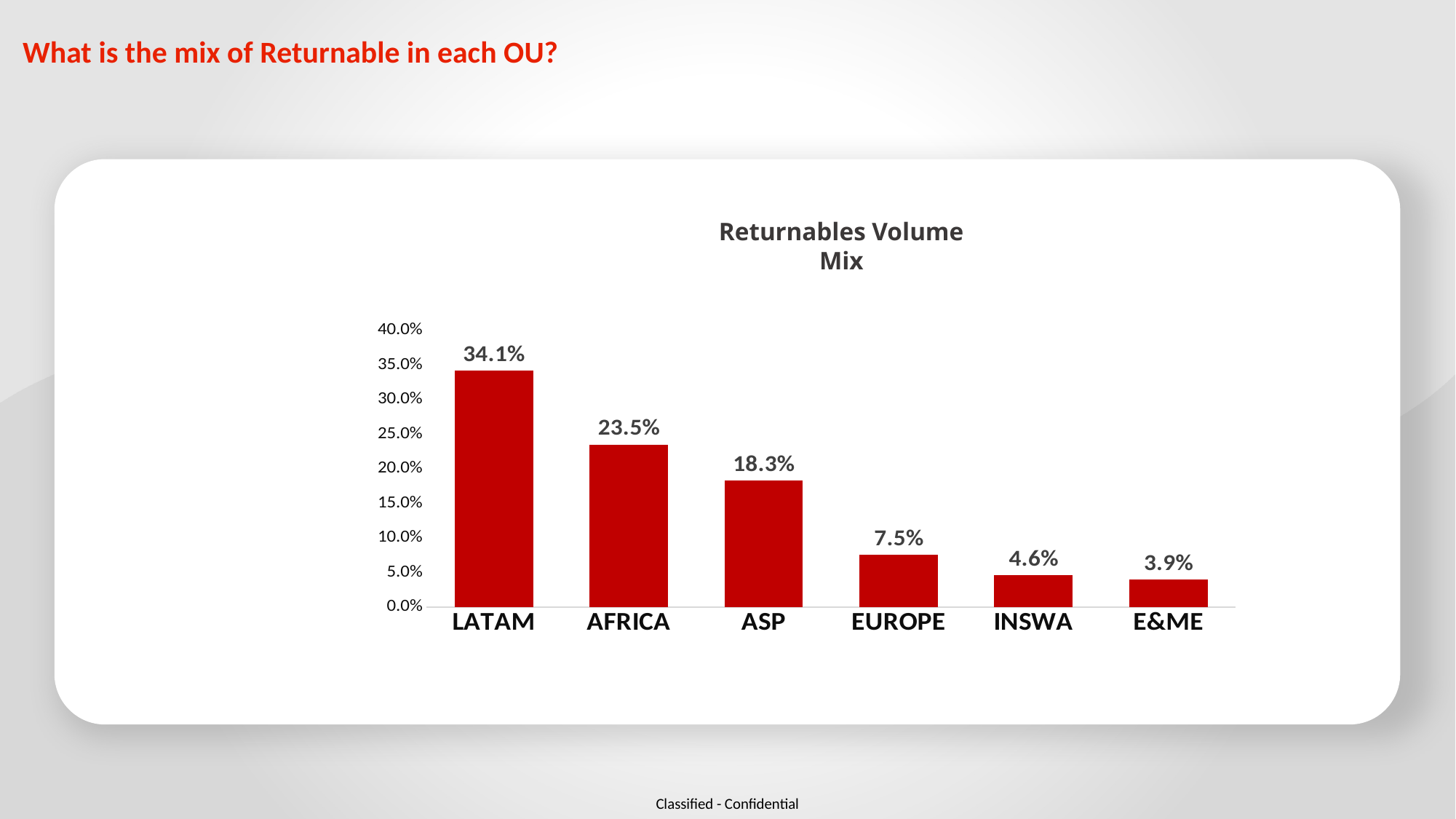
Which OU has the highest Returnables Volume Mix? LATAM How many OUs are shown in the Returnables Volume Mix chart? 6 What is the difference between the Returnables Volume Mix for LATAM and AFRICA? 10.6% What is the Returnables Volume Mix value for LATAM? 34.1% What is the Returnables Volume Mix value for AFRICA? 23.5% What is the difference between the Returnables Volume Mix for ASP and EUROPE? 10.8% What kind of chart is used to show the Returnables Volume Mix? Bar chart Do the values rise or fall from left to right across the OUs in the Returnables Volume Mix chart? Fall What is the Returnables Volume Mix value for E&ME? 3.9% Which has a larger Returnables Volume Mix, INSWA or EUROPE? EUROPE What is the Returnables Volume Mix value for EUROPE? 7.5% Which OU has the lowest Returnables Volume Mix? E&ME